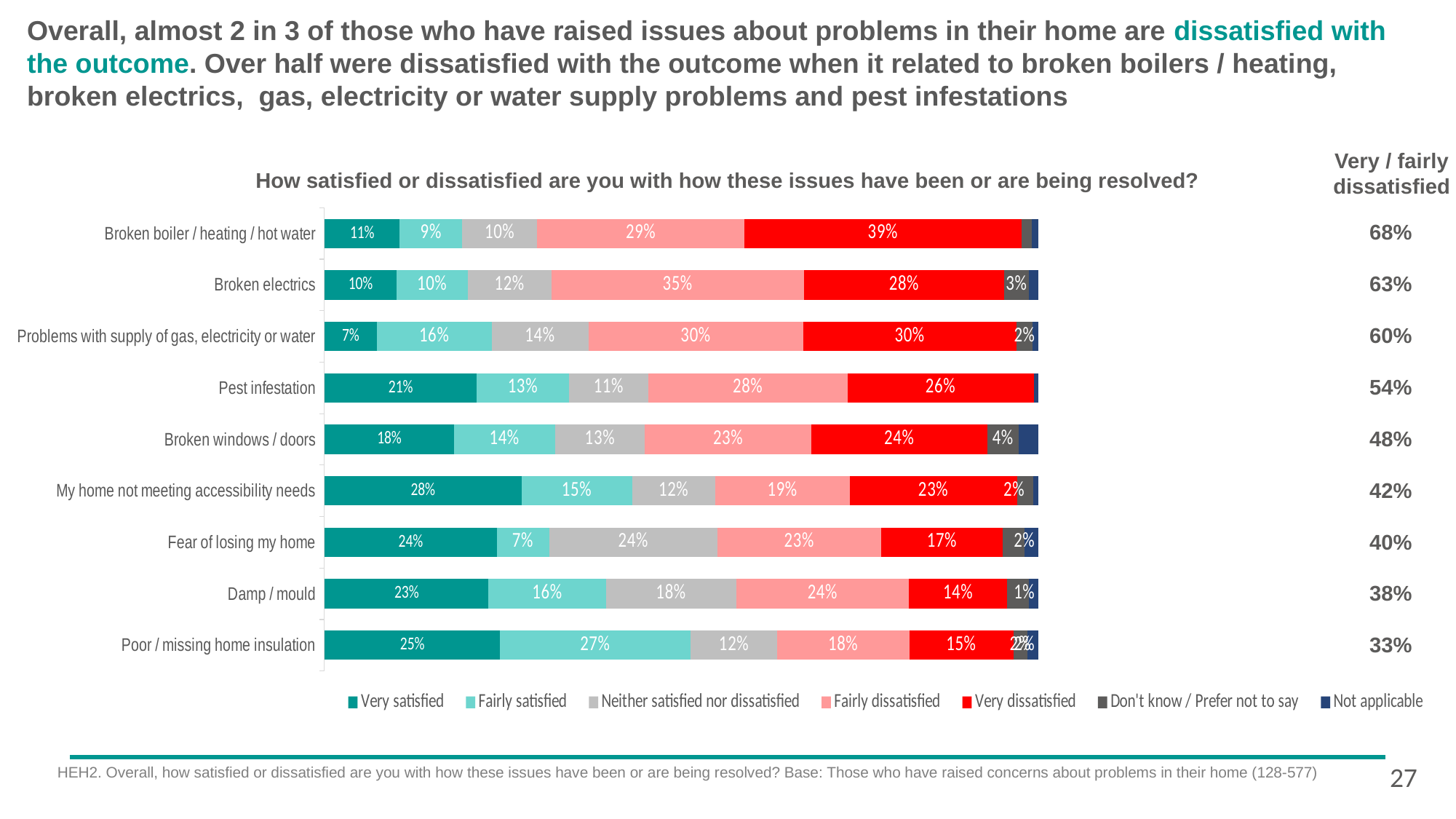
How many issue categories are shown in the chart? 9 Which issue has the highest 'Very dissatisfied' percentage? Broken boiler / heating / hot water How many series does the legend list? 7 Which issue has the highest 'Very satisfied' percentage? My home not meeting accessibility needs Which has a larger 'Fairly dissatisfied' percentage: broken electrics or pest infestation? Broken electrics What is the 'Very / fairly dissatisfied' percentage shown for poor / missing home insulation? 33% Which issue has the lowest 'Very satisfied' percentage? Problems with supply of gas, electricity or water What type of chart is shown on the slide? Stacked bar chart What percentage of respondents with damp / mould issues were very satisfied? 23% What percentage of respondents with a broken boiler / heating / hot water issue were very dissatisfied? 39% What is the difference in the 'Very dissatisfied' percentage between broken boiler / heating / hot water and damp / mould? 25 percentage points What percentage of respondents with broken electrics were fairly dissatisfied? 35%